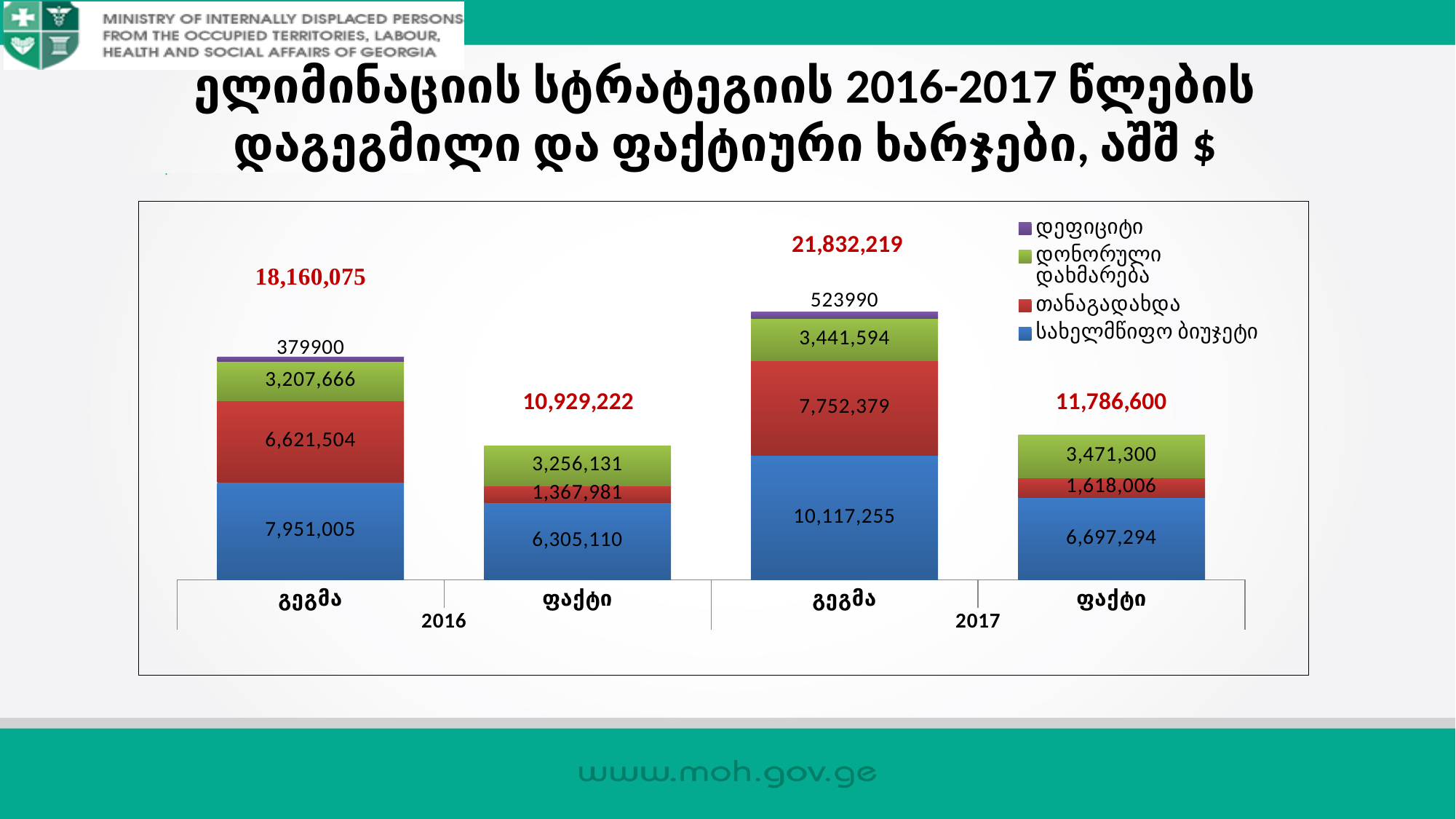
What total is printed above the 2017 გეგმა bar? 21,832,219 Which bar has the highest total? 2017 გეგმა How many series does the legend list? 4 What is the difference between the სახელმწიფო ბიუჯეტი values of the 2016 გეგმა and 2016 ფაქტი bars? 1,645,895 What type of chart is shown on the slide? stacked bar chart What is the value of დეფიციტი for the 2016 გეგმა bar? 379900 What is the value of დონორული დახმარება for the 2017 ფაქტი bar? 3,471,300 What is the value of სახელმწიფო ბიუჯეტი for the 2017 გეგმა bar? 10,117,255 Which is larger: თანაგადახდა for 2017 გეგმა or თანაგადახდა for 2017 ფაქტი? 2017 გეგმა Which bar has the lowest total? 2016 ფაქტი How many bars are plotted in the chart? 4 What is the value of თანაგადახდა for the 2016 ფაქტი bar? 1,367,981